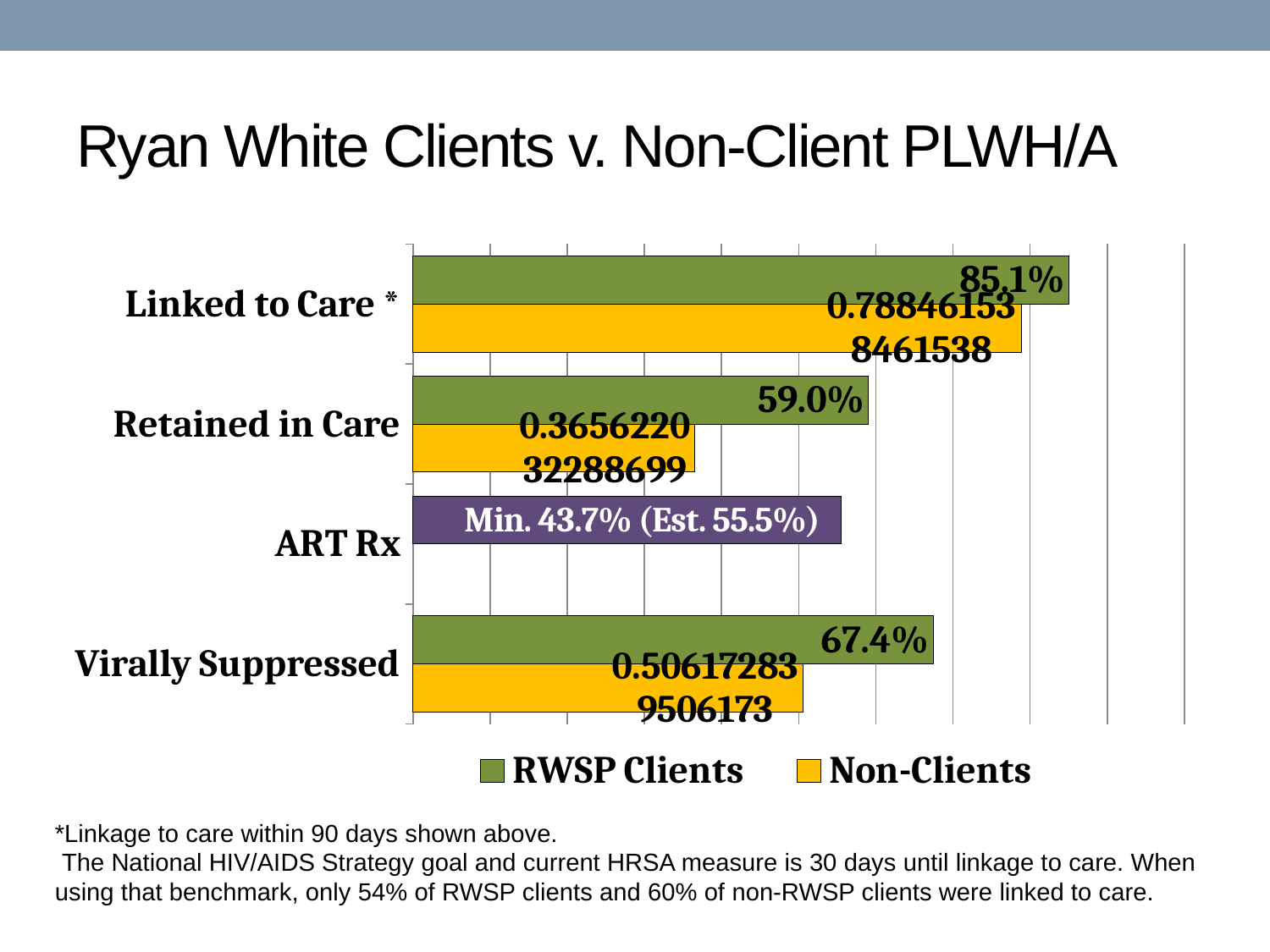
How many categories are shown on the chart's vertical axis? 4 How many series does the chart legend list? 2 What colour represents Non-Clients in the chart legend? Yellow What label is printed on the ART Rx bar? Min. 43.7% (Est. 55.5%) Which category has the lowest Non-Clients value? Retained in Care Which category has the highest RWSP Clients value? Linked to Care What is the difference between the RWSP Clients values for Linked to Care and Retained in Care? 26.1 percentage points What kind of chart is shown on the slide? Bar chart What is the RWSP Clients value for Retained in Care? 59.0% What is the RWSP Clients value for Linked to Care? 85.1% For Linked to Care, which is larger: the RWSP Clients bar or the Non-Clients bar? RWSP Clients What is the RWSP Clients value for Virally Suppressed? 67.4%